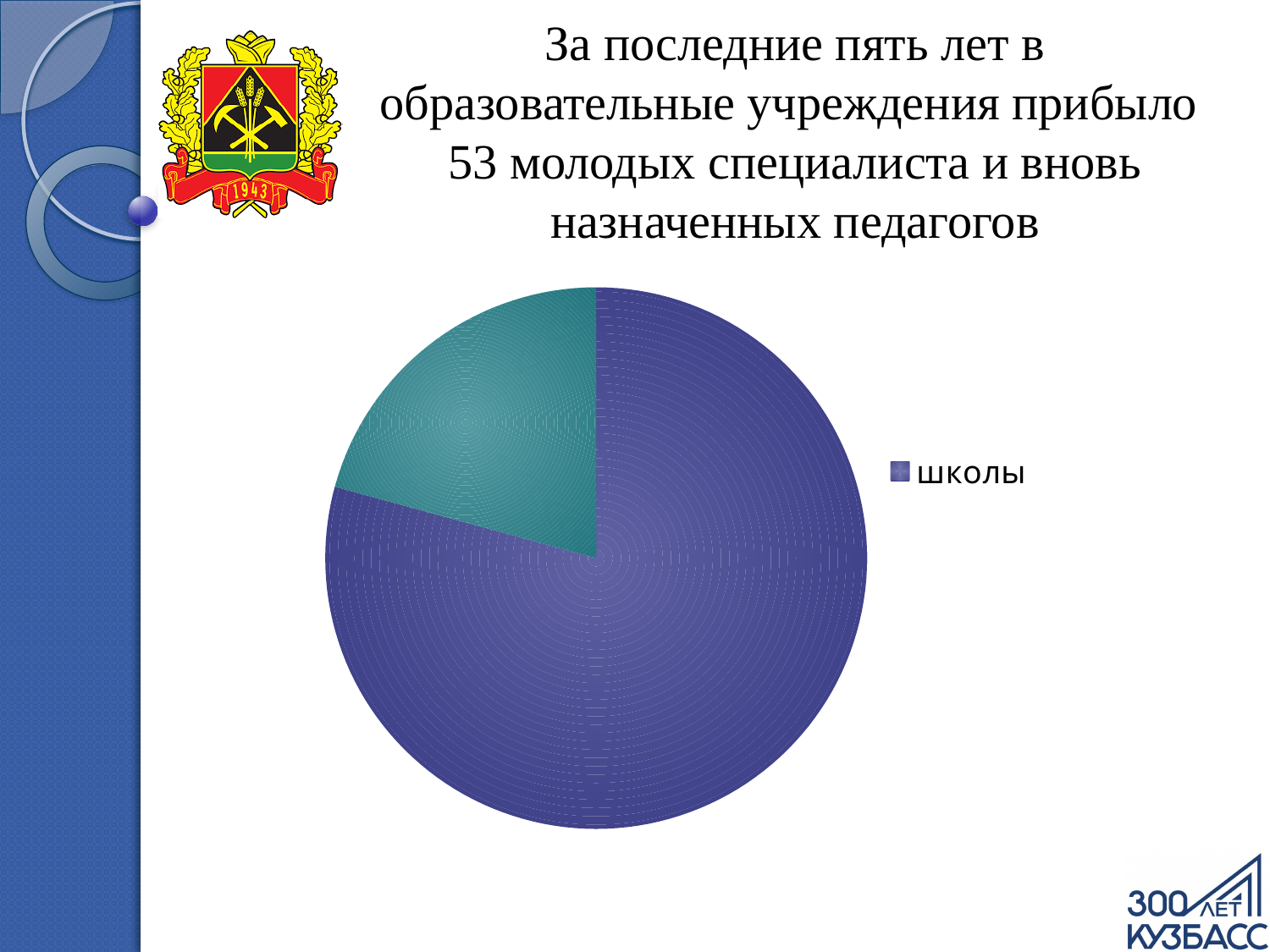
What is the only entry shown in the legend of the pie chart? школы Does the slice for школы take up more or less than half of the pie? more How many entries does the legend of the pie chart list? 1 What colour is the slice for школы in the pie chart? blue What kind of chart is shown on the slide? pie chart Which labelled category has the largest slice in the pie chart? школы How many slices does the pie chart have? 2 Is the blue slice (школы) larger or smaller than the teal slice? larger